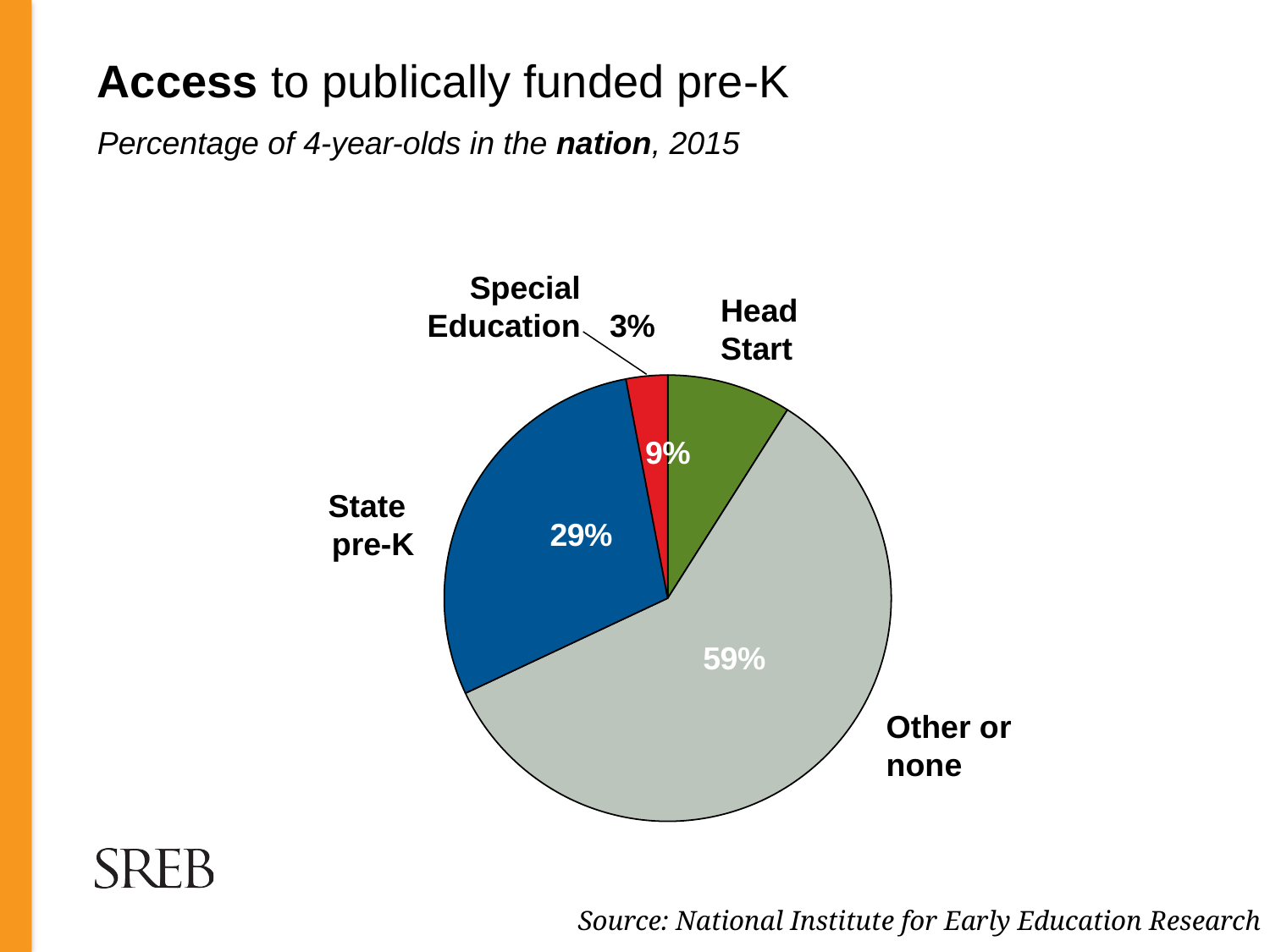
What percentage of 4-year-olds fall under Other or none? 59% Which category has the smallest share of the pie? Special Education What is the difference in percentage points between State pre-K and Head Start? 20 What is the difference in percentage points between Other or none and State pre-K? 30 What colour is the State pre-K slice? Blue How many categories are shown in the pie chart? 4 Which is larger, the share for Head Start or the share for Special Education? Head Start What percentage of 4-year-olds are in Head Start? 9% What percentage of 4-year-olds are in Special Education? 3% What kind of chart is shown on the slide? Pie chart What percentage of 4-year-olds are in State pre-K? 29% Which category has the largest share of the pie? Other or none